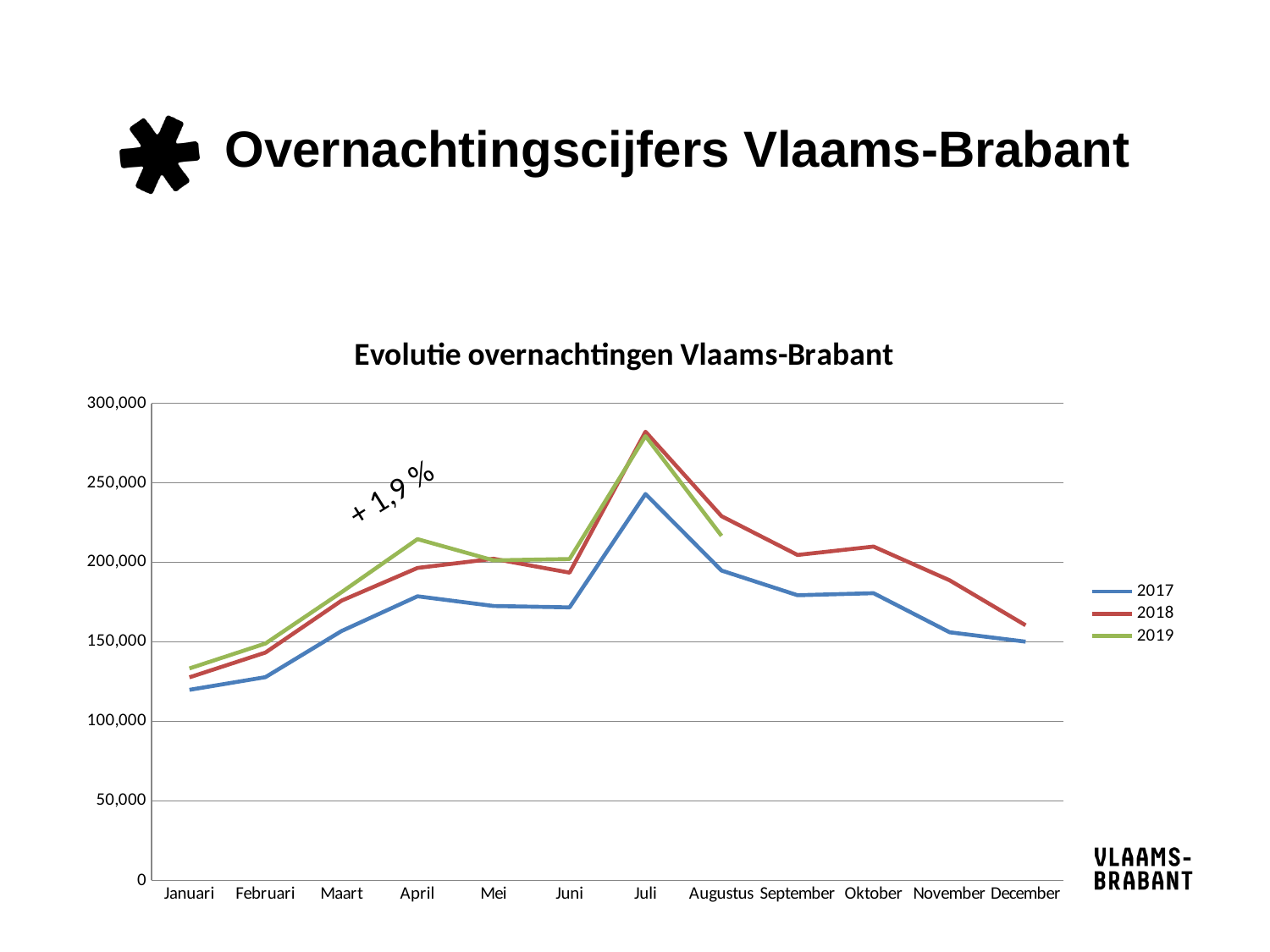
What is the title of the chart? Evolutie overnachtingen Vlaams-Brabant In which month does the 2018 line reach its highest value? Juli Is the value for 2018 in Juli greater or less than 250,000? greater Is the value for 2019 in April greater or less than 200,000? greater How many months are shown on the x axis? 12 Does the 2017 line rise or fall from Juli to December? fall In which month is the 2017 line at its lowest value? Januari Which is larger in April: the value for 2019 or the value for 2017? 2019 Is the value for 2017 in Juli greater or less than 200,000? greater What kind of chart is shown on the slide? line chart How many series does the legend list? 3